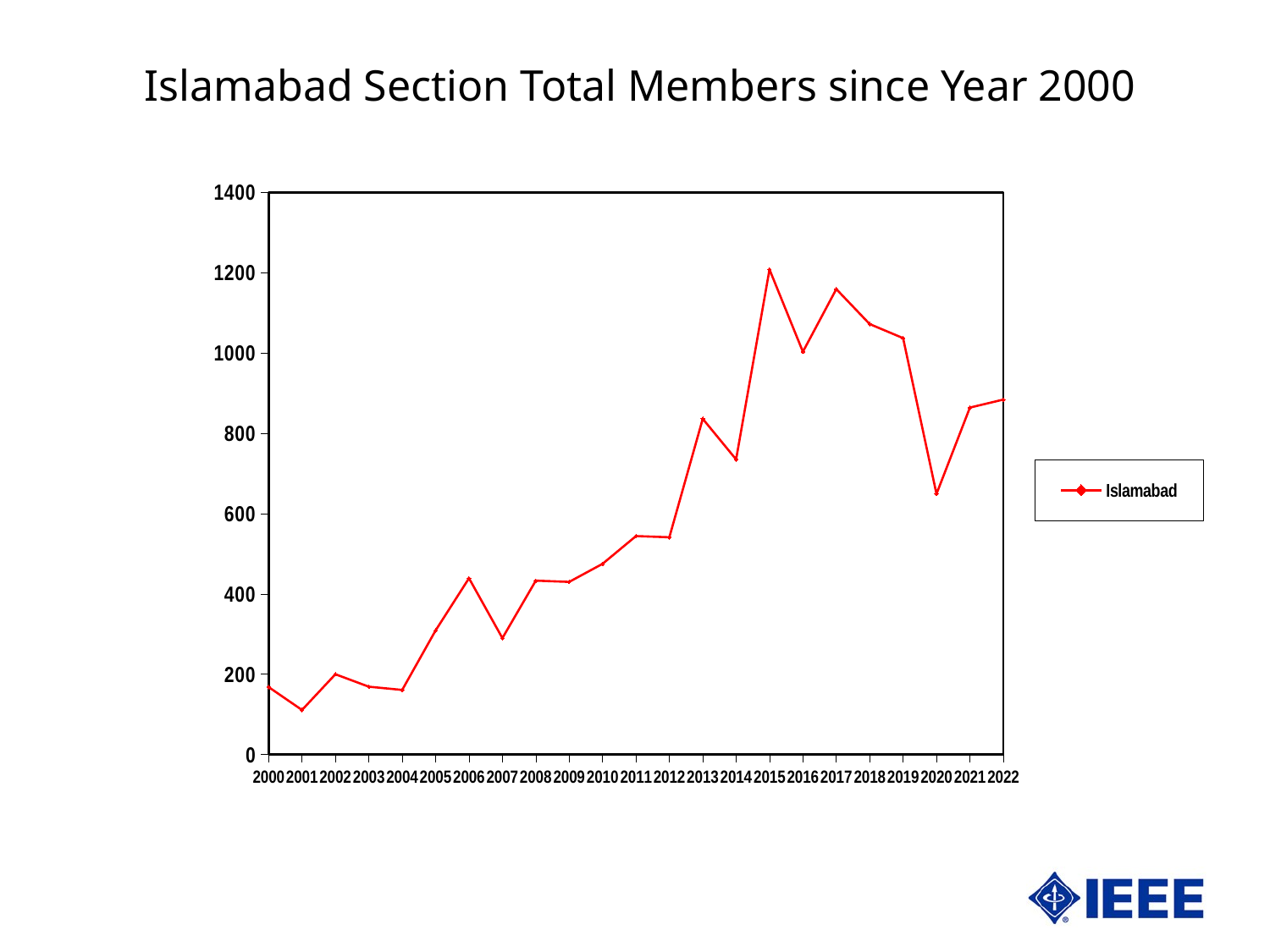
In which year is the number of members highest? 2015 What is the name of the series shown in the legend? Islamabad Which year has more members, 2013 or 2014? 2013 How many series does the legend list? 1 How many years are plotted along the x axis? 23 Is the value for 2007 greater or less than 400? less Is the value for 2020 greater or less than 800? less What is the title of the chart? Islamabad Section Total Members since Year 2000 Do the values rise or fall from 2017 to 2020? fall What kind of chart is shown on the slide? line chart In which year is the number of members lowest? 2001